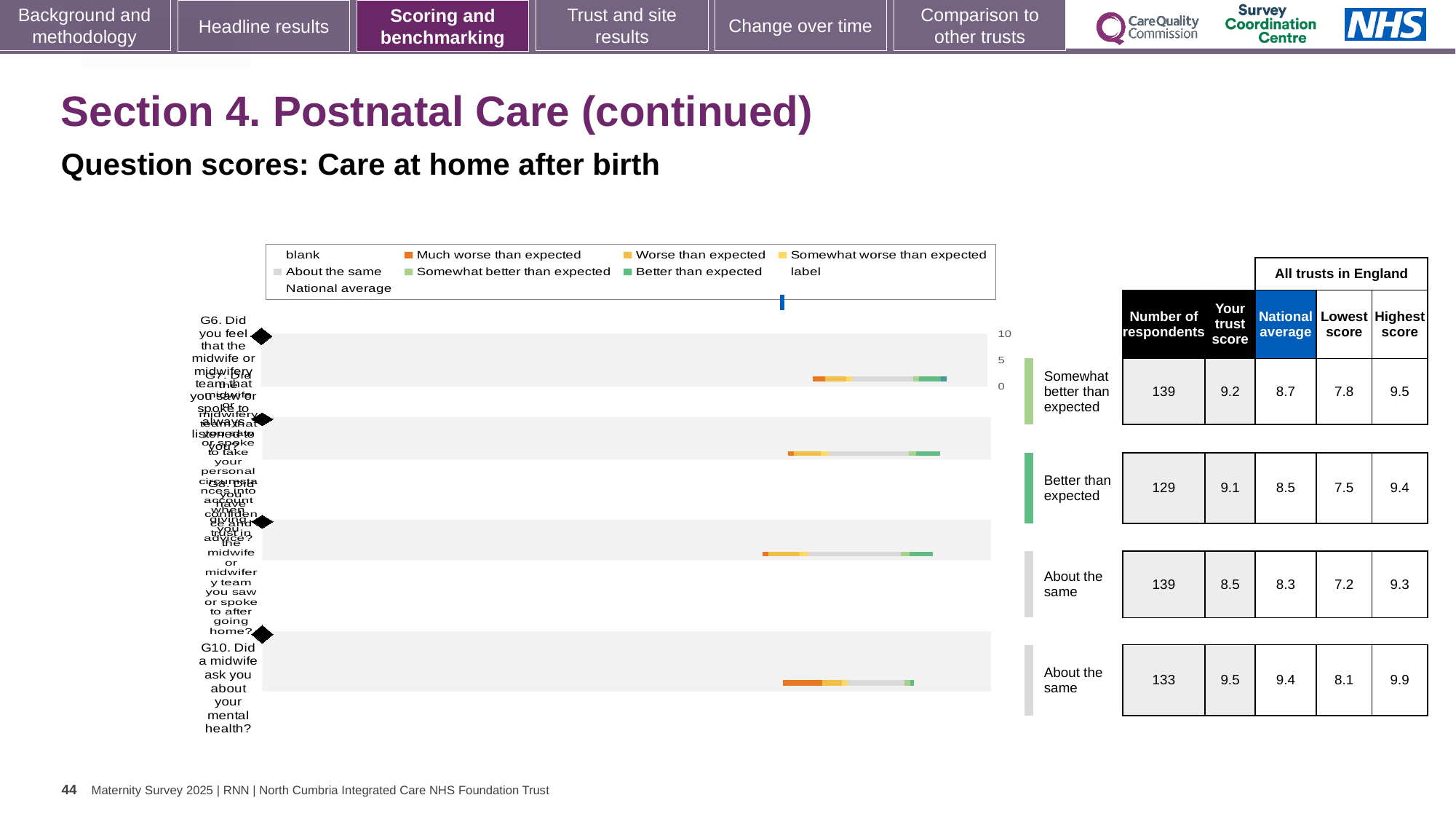
What kind of chart is shown on the slide? bar chart What is the trust score for the top bar, question G6? 9.2 What is the highest score among all trusts in England for question G10? 9.9 What is the national average for question G10 (Did a midwife ask you about your mental health?)? 9.4 What benchmark category is shown for question G6 (top bar)? Somewhat better than expected What is the difference between the trust score and the national average for question G6 (top bar)? 0.5 What benchmark category is shown for question G10 (bottom bar)? About the same How many respondents answered question G10 (Did a midwife ask you about your mental health?)? 133 What is the trust score for question G10 (Did a midwife ask you about your mental health?)? 9.5 Which is larger for question G10: the trust score or the national average? the trust score How many question bars are plotted in the chart? 4 Is the trust score for question G10 greater or less than 5 on the chart axis? greater